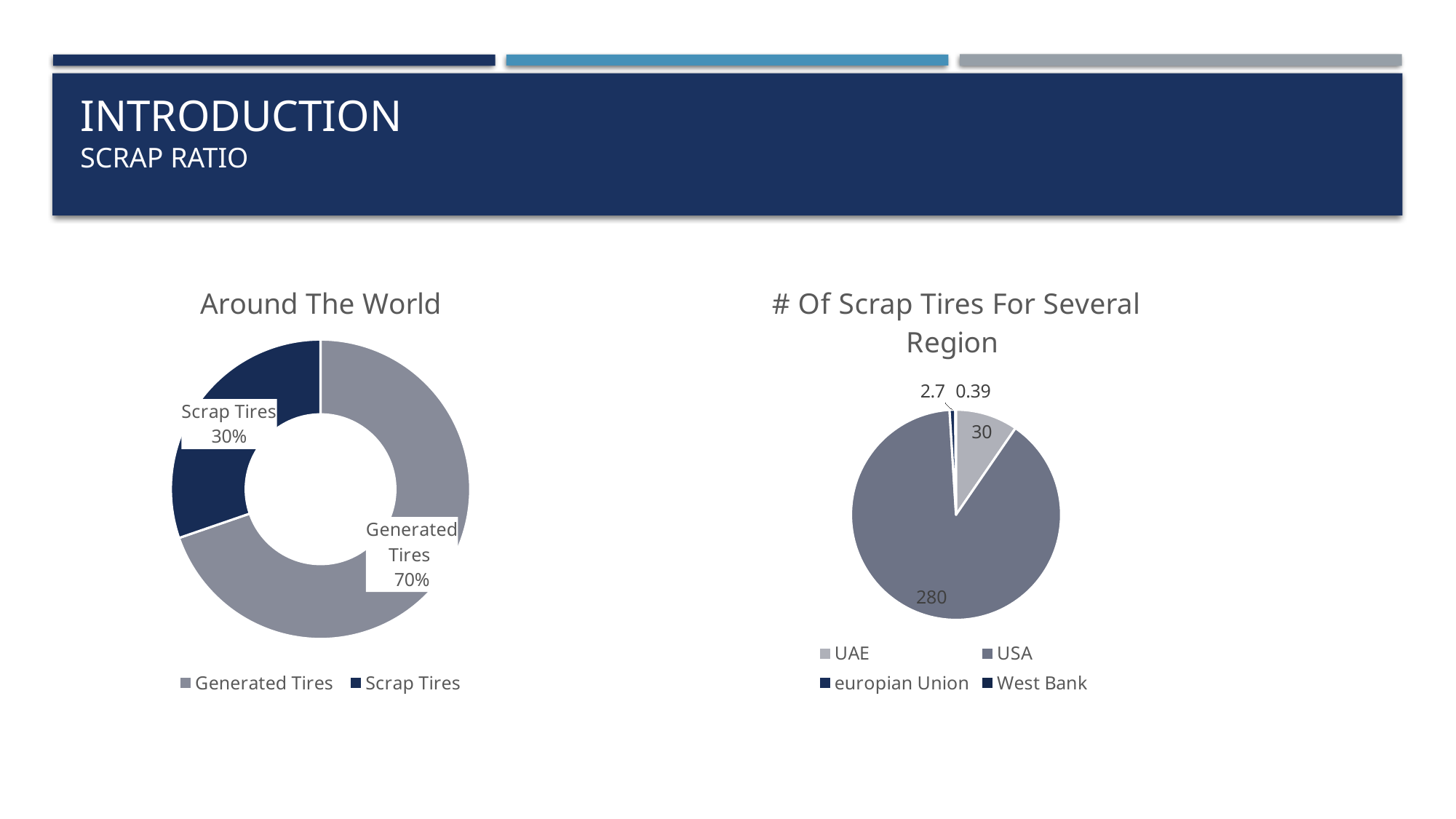
What kind of chart is the 'Around The World' chart? Doughnut chart On the 'Around The World' chart, what percentage is shown for Generated Tires? 70% On the '# Of Scrap Tires For Several Region' chart, which region has the largest value? USA On the '# Of Scrap Tires For Several Region' chart, what value is shown for UAE? 30 On the '# Of Scrap Tires For Several Region' chart, what is the difference between the values for USA and UAE? 250 How many regions does the legend of the '# Of Scrap Tires For Several Region' chart list? 4 On the 'Around The World' chart, what is the difference in percentage points between Generated Tires and Scrap Tires? 40 On the 'Around The World' chart, what percentage is shown for Scrap Tires? 30% On the '# Of Scrap Tires For Several Region' chart, which region has the smallest value? West Bank How many categories does the legend of the 'Around The World' chart list? 2 On the '# Of Scrap Tires For Several Region' chart, what value is shown for USA? 280 On the 'Around The World' chart, which category has the larger share? Generated Tires